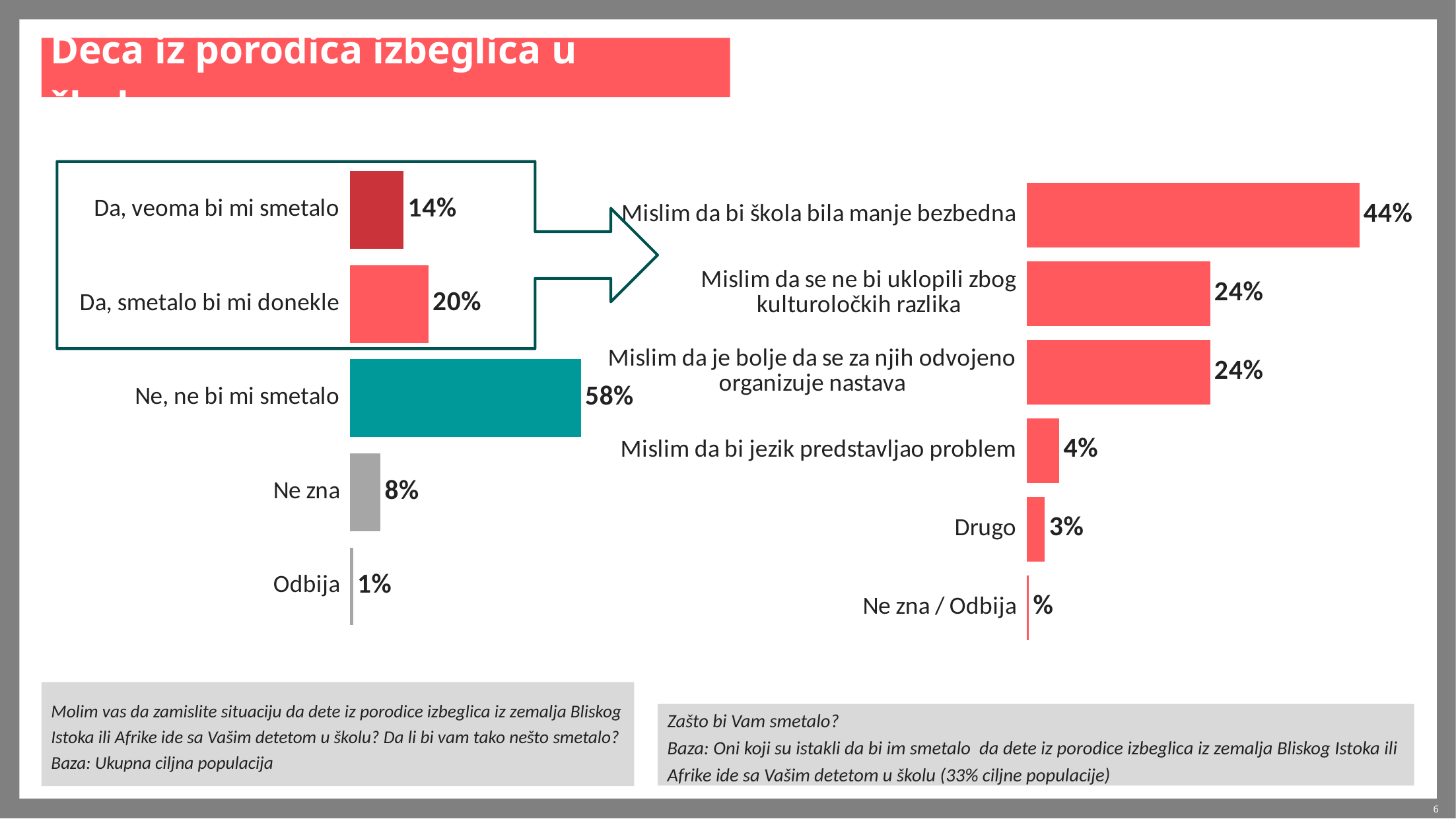
In the left chart, which category has the highest value? Ne, ne bi mi smetalo In the right chart, what is the value for "Mislim da bi škola bila manje bezbedna"? 44% In the left chart, what is the difference between "Da, smetalo bi mi donekle" and "Da, veoma bi mi smetalo"? 6% What kind of chart is the right chart? Bar chart In the left chart, which category has the lowest value? Odbija In the right chart, what is the difference between "Mislim da bi škola bila manje bezbedna" and "Mislim da bi jezik predstavljao problem"? 40% In the left chart, what is the value for "Ne, ne bi mi smetalo"? 58% How many categories does the left chart show? 5 In the right chart, which category has the highest value? Mislim da bi škola bila manje bezbedna In the left chart, which is larger: "Ne zna" or "Da, veoma bi mi smetalo"? Da, veoma bi mi smetalo In the right chart, what is the value for "Drugo"? 3% In the left chart, what is the value for "Da, veoma bi mi smetalo"? 14%